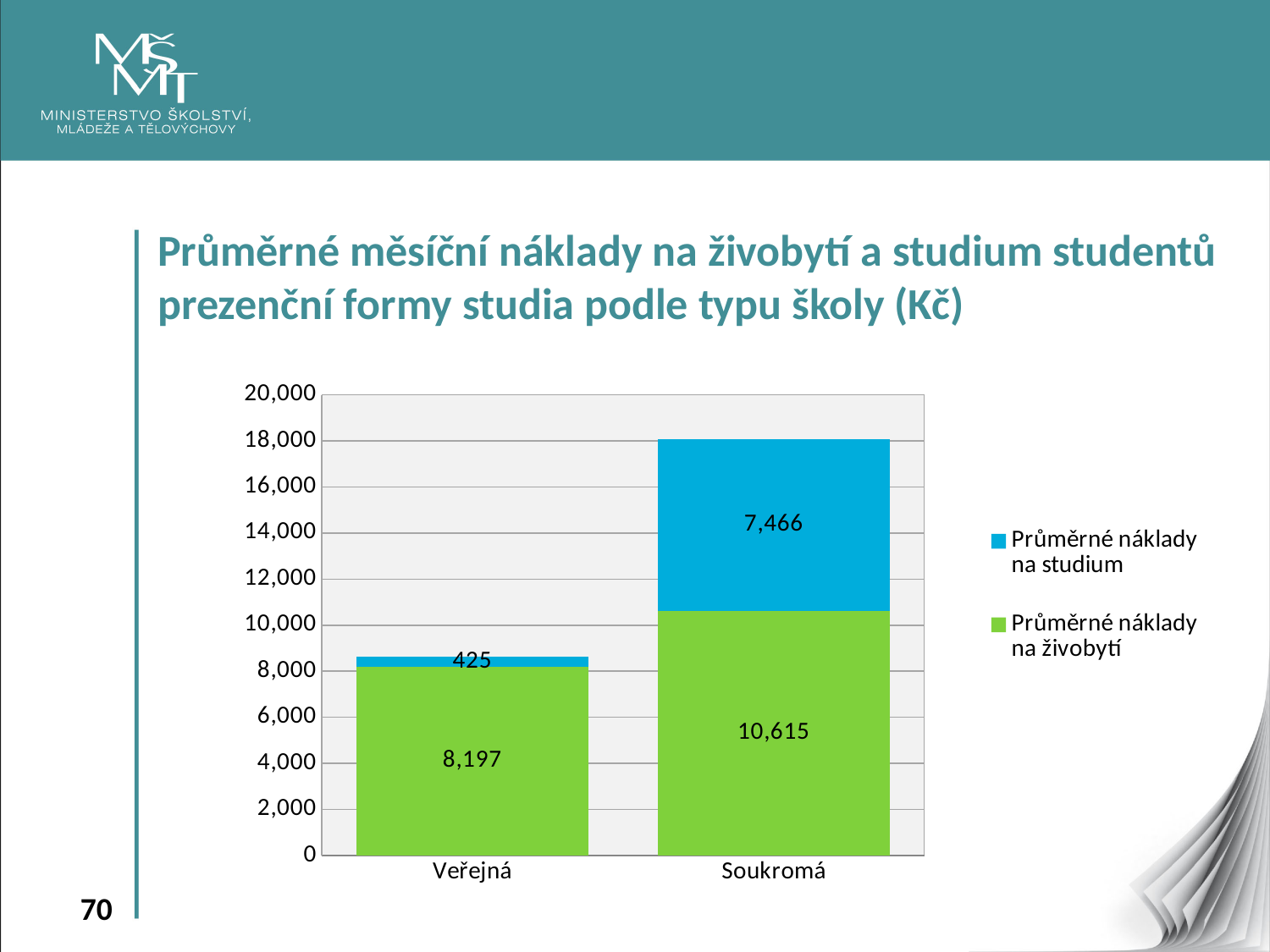
What is the total of the stacked bar for Soukromá? 18,081 What is the total of the stacked bar for Veřejná? 8,622 What is the difference between Průměrné náklady na živobytí for Soukromá and for Veřejná? 2,418 What is the value of Průměrné náklady na studium for Soukromá? 7,466 What is the value of Průměrné náklady na studium for Veřejná? 425 What is the value of Průměrné náklady na živobytí for Soukromá? 10,615 Which colour represents Průměrné náklady na živobytí in the legend? Green How many series does the legend list? 2 What is the value of Průměrné náklady na živobytí for Veřejná? 8,197 Which category has the higher Průměrné náklady na studium, Veřejná or Soukromá? Soukromá What kind of chart is shown on the slide? Stacked bar chart How many categories are shown on the x axis? 2